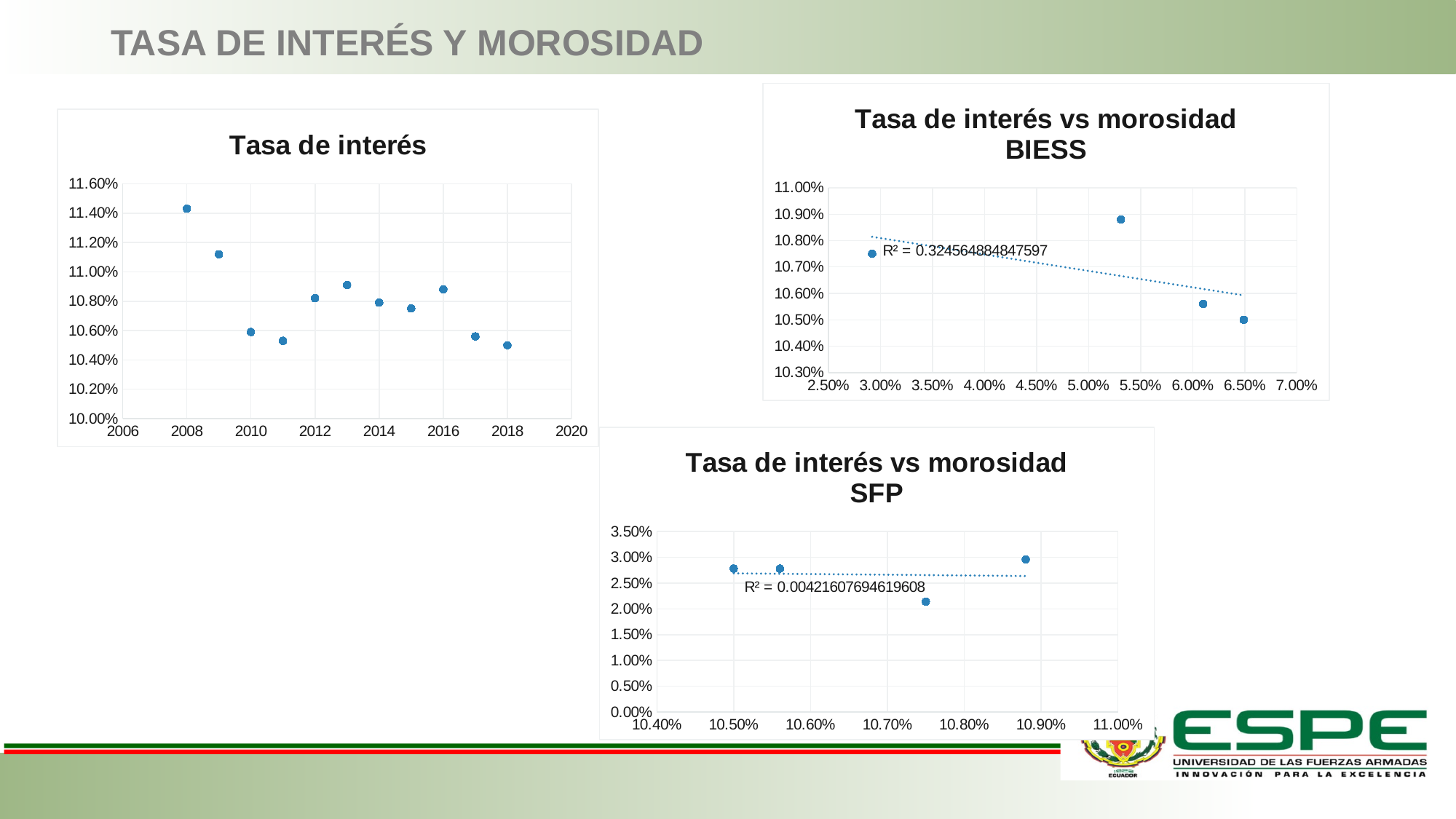
In the "Tasa de interés" chart, is the value for 2013 greater or less than 10.80%? greater In the "Tasa de interés" chart, which is larger, the value for 2009 or the value for 2010? 2009 What R² value is shown on the "Tasa de interés vs morosidad BIESS" chart? R² = 0.324564884847597 What R² value is shown on the "Tasa de interés vs morosidad SFP" chart? R² = 0.00421607694619608 In the "Tasa de interés" chart, which year has the highest interest rate? 2008 How many data points are plotted in the "Tasa de interés" chart? 11 What type of chart is the "Tasa de interés" chart on the left? Scatter chart In the "Tasa de interés" chart, is the value for 2018 greater or less than 10.60%? less How many data points are plotted in the "Tasa de interés vs morosidad SFP" chart? 4 In the "Tasa de interés" chart, is the value for 2008 greater or less than 11.20%? greater In the "Tasa de interés" chart, which year has the lowest interest rate? 2018 In the "Tasa de interés" chart, do the values generally rise or fall from 2008 to 2018? Fall